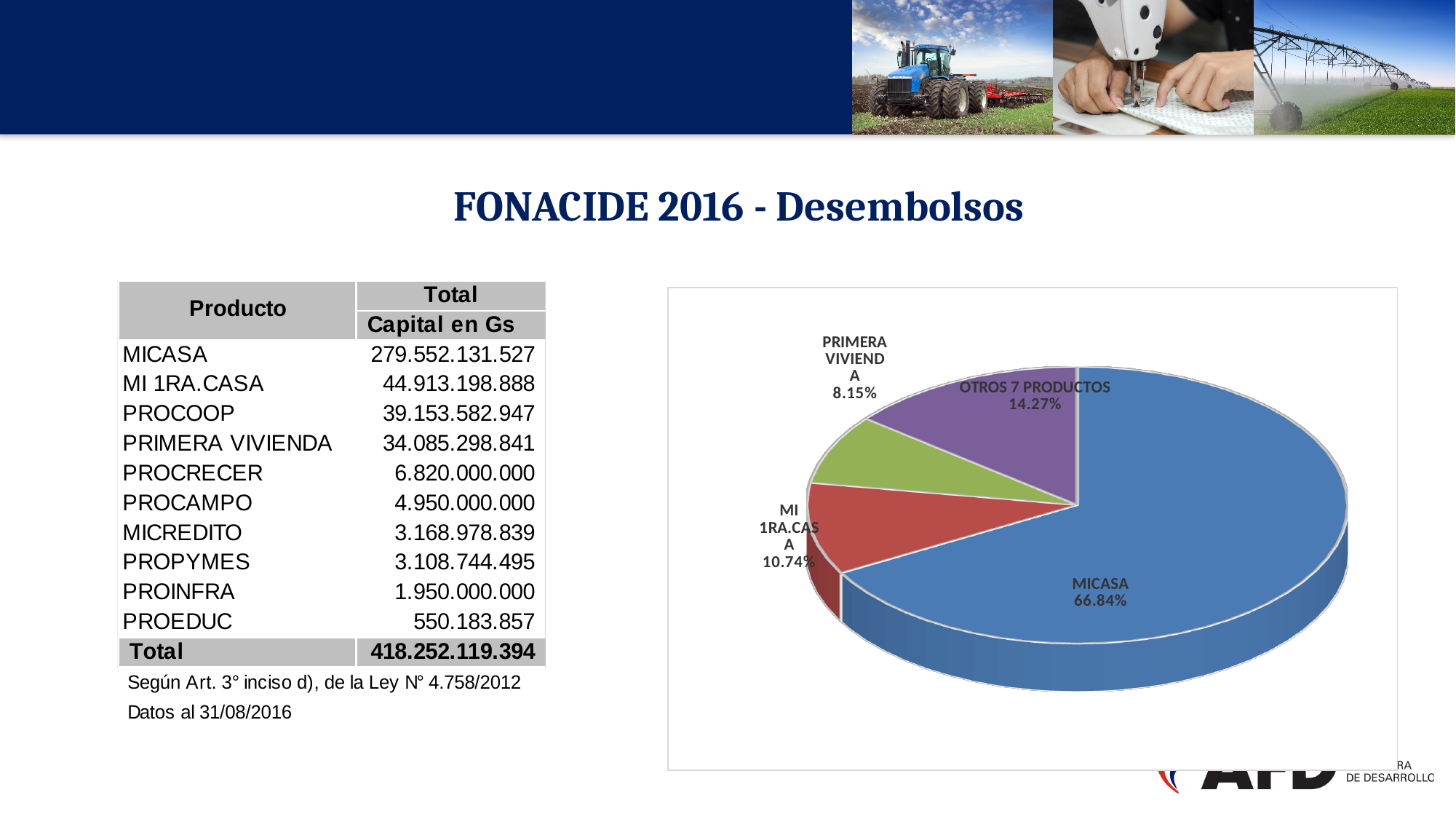
What share of the pie chart does MICASA represent? 66.84% What percentage is shown for the PRIMERA VIVIENDA slice in the pie chart? 8.15% Which is larger in the pie chart, the MI 1RA.CASA slice or the PRIMERA VIVIENDA slice? MI 1RA.CASA What is the difference in percentage points between the MICASA slice and the OTROS 7 PRODUCTOS slice? 52.57% Which slice of the pie chart is the largest? MICASA What colour is the MICASA slice in the pie chart? Blue What percentage is shown for the OTROS 7 PRODUCTOS slice in the pie chart? 14.27% What percentage is shown for the MI 1RA.CASA slice in the pie chart? 10.74% What kind of chart is shown on the slide? Pie chart Which slice of the pie chart is the smallest? PRIMERA VIVIENDA How many slices does the pie chart have? 4 What is the difference in percentage points between the OTROS 7 PRODUCTOS slice and the MI 1RA.CASA slice? 3.53%